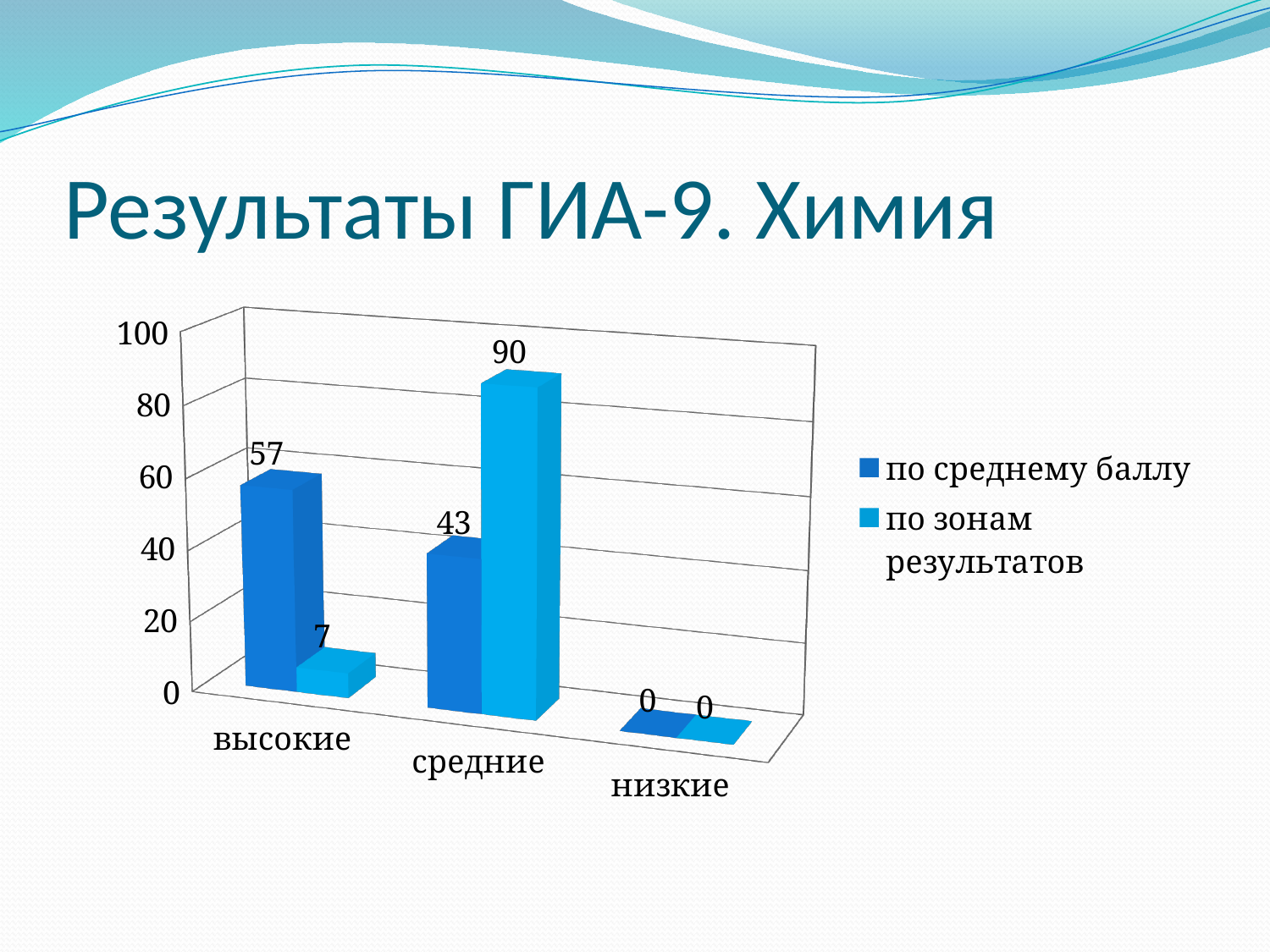
What is the difference between the two series for the category средние? 47 How many series does the legend list? 2 How many categories are shown on the x axis? 3 What kind of chart is shown on the slide? bar chart What is the value for высокие in the series по зонам результатов? 7 Which category has the highest value in the series по среднему баллу? высокие What is the value for средние in the series по зонам результатов? 90 What is the difference between the two series for the category высокие? 50 What is the value for высокие in the series по среднему баллу? 57 What is the value for средние in the series по среднему баллу? 43 Which category has the highest value in the series по зонам результатов? средние For the category высокие, which series has the larger value: по среднему баллу or по зонам результатов? по среднему баллу